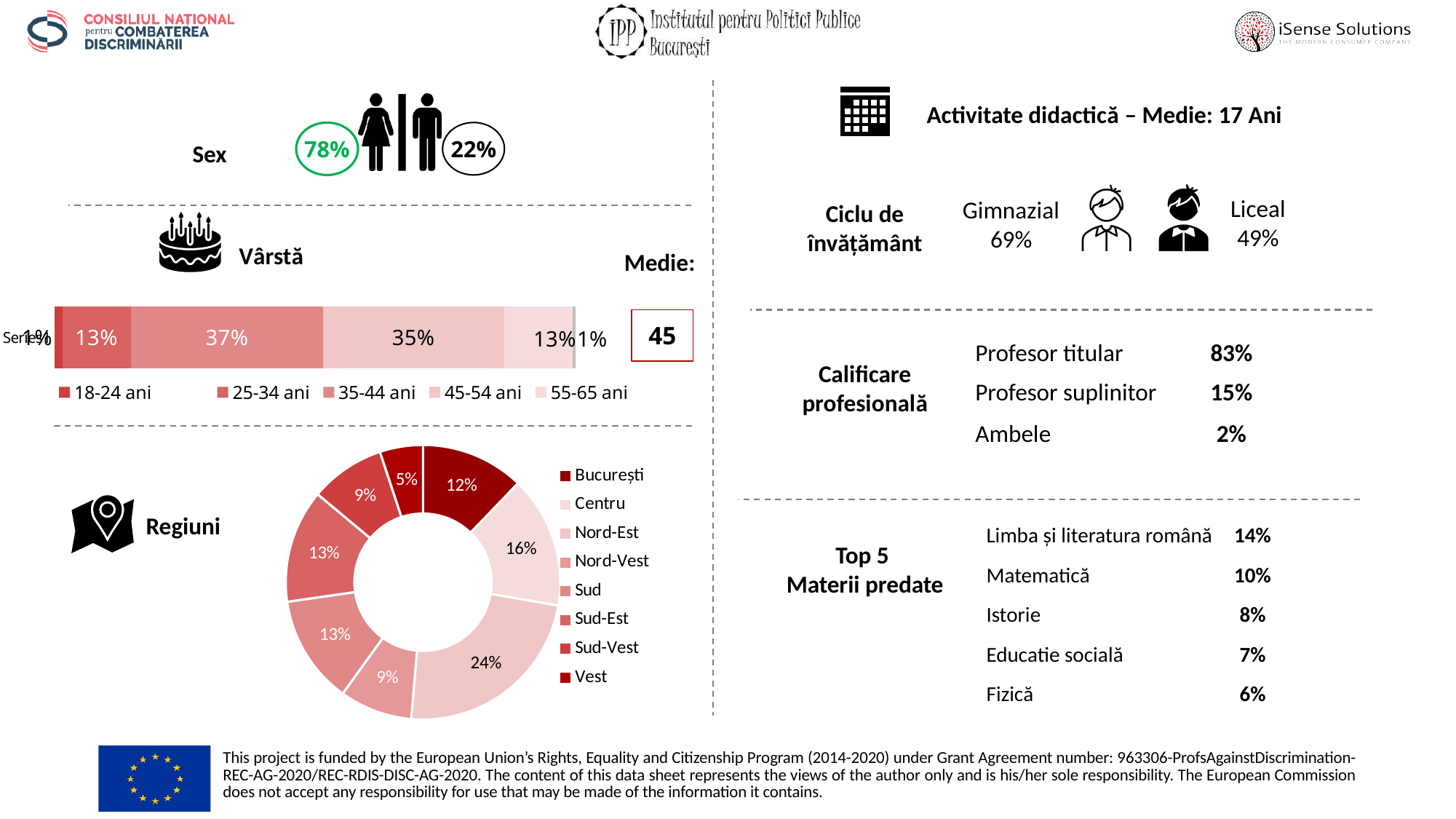
How many regions does the legend of the Regiuni chart list? 8 In the Regiuni chart, which region has the smallest share? Vest In the Vârstă chart, which age group has the largest percentage? 35-44 ani In the Regiuni chart, what share is shown for Nord-Est? 24% In the Regiuni chart, what is the difference between the shares of Nord-Est and Centru? 8 percentage points In the Regiuni chart, what share is shown for București? 12% In the Vârstă chart, what percentage is shown for 35-44 ani? 37% In the Regiuni chart, which is larger: the share for București or for Centru? Centru What kind of chart is the Vârstă chart? Stacked bar chart How many age groups does the legend of the Vârstă chart list? 5 In the Regiuni chart, which region has the largest share? Nord-Est What kind of chart is the Regiuni chart? Donut (pie) chart